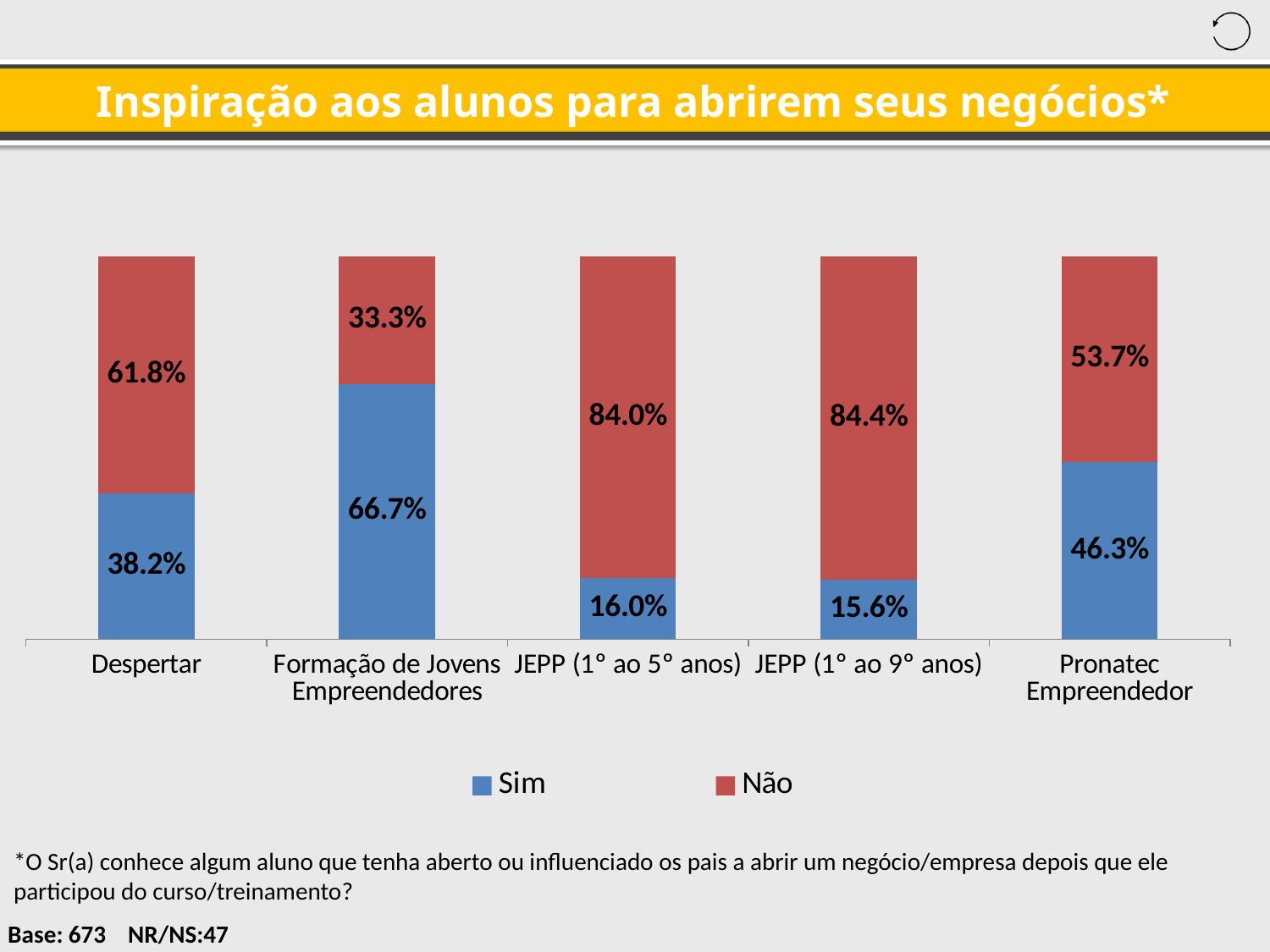
What is the 'Sim' value for Despertar? 38.2% Which category has the lowest 'Não' value? Formação de Jovens Empreendedores How many series does the legend list? 2 What kind of chart is shown on the slide? Stacked bar chart What is the 'Sim' value for JEPP (1° ao 9° anos)? 15.6% How many categories are shown on the x axis? 5 What is the 'Não' value for Pronatec Empreendedor? 53.7% Which category has the highest 'Sim' value? Formação de Jovens Empreendedores Which category has the lowest 'Sim' value? JEPP (1° ao 9° anos) Which is larger: the 'Sim' value for Pronatec Empreendedor or the 'Sim' value for Despertar? Pronatec Empreendedor Which colour represents the 'Não' series? Red What is the difference between the 'Não' and 'Sim' values for Despertar? 23.6%